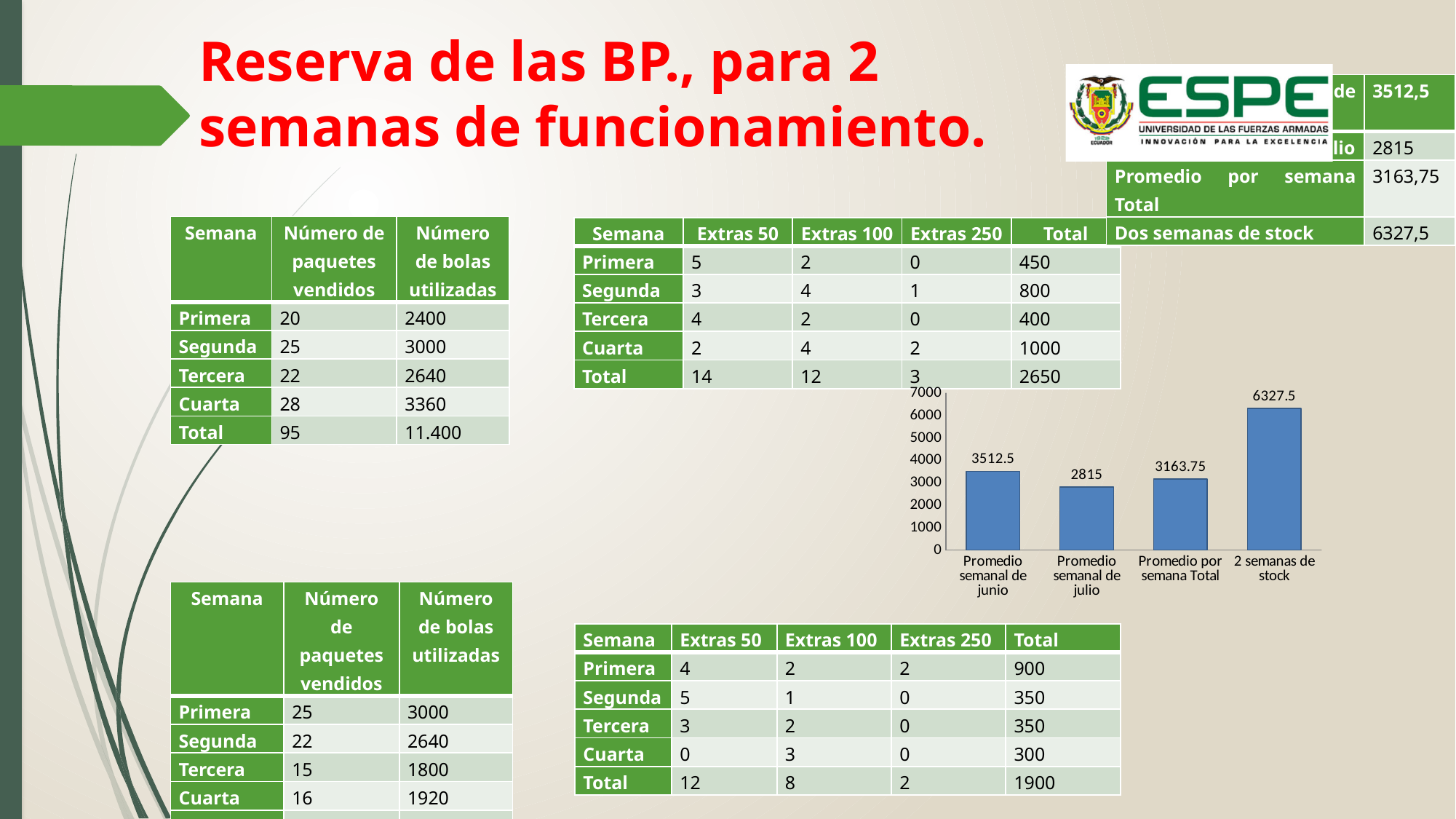
What is the difference between the 'Promedio semanal de junio' bar and the 'Promedio semanal de julio' bar? 697.5 What kind of chart is shown on the slide? Bar chart What is the value of the bar for 'Promedio por semana Total'? 3163.75 What is the value of the bar for '2 semanas de stock'? 6327.5 Which category has the lowest bar in the chart? Promedio semanal de julio Which is larger, the bar for 'Promedio semanal de junio' or the bar for 'Promedio por semana Total'? Promedio semanal de junio Which category has the highest bar in the chart? 2 semanas de stock What is the value of the bar for 'Promedio semanal de julio'? 2815 What is the difference between the '2 semanas de stock' bar and the 'Promedio semanal de junio' bar? 2815 Is the value for '2 semanas de stock' greater or less than 5000? greater How many bars are plotted in the chart? 4 What is the value of the bar for 'Promedio semanal de junio'? 3512.5